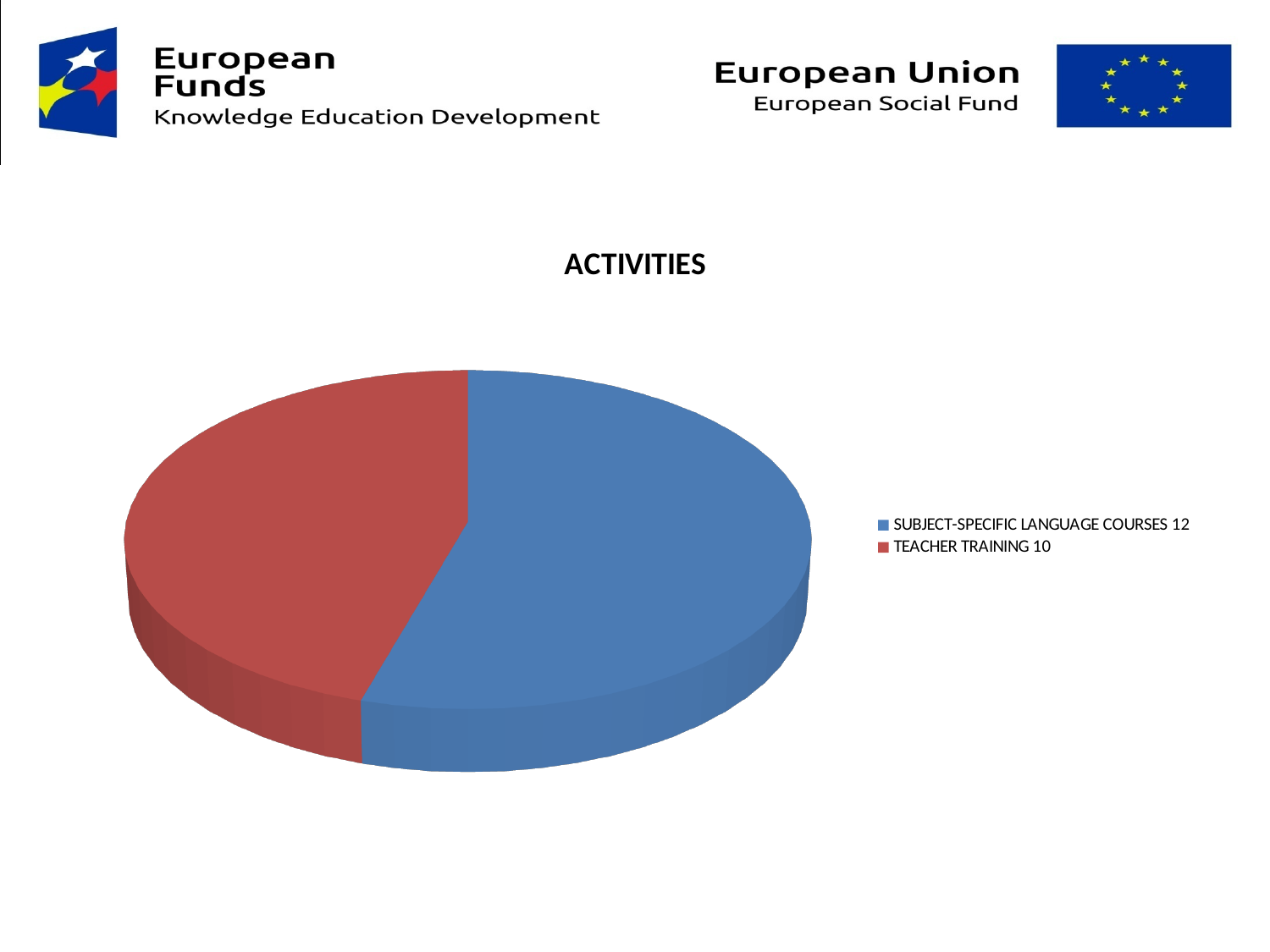
Which activity has the smallest slice of the pie? TEACHER TRAINING How many slices does the pie chart have? 2 Which is larger, SUBJECT-SPECIFIC LANGUAGE COURSES or TEACHER TRAINING? SUBJECT-SPECIFIC LANGUAGE COURSES What is the difference between the values for SUBJECT-SPECIFIC LANGUAGE COURSES and TEACHER TRAINING? 2 What value is given for SUBJECT-SPECIFIC LANGUAGE COURSES? 12 What colour is the TEACHER TRAINING slice? red What is the total of the two values shown in the legend? 22 What value is given for TEACHER TRAINING? 10 Which activity has the largest slice of the pie? SUBJECT-SPECIFIC LANGUAGE COURSES How many entries does the legend list? 2 What kind of chart is shown on the slide? pie chart What is the title of the chart? ACTIVITIES